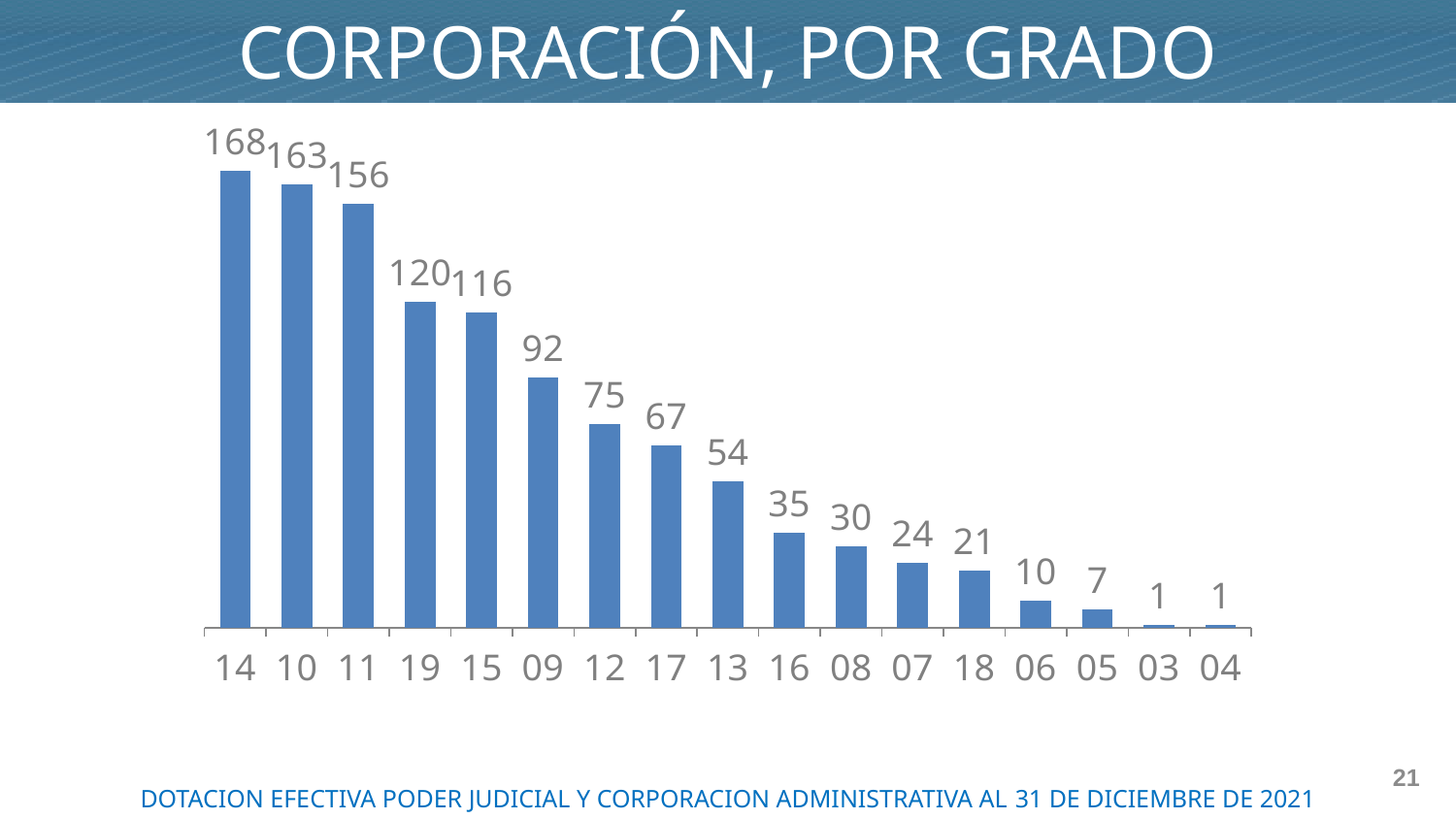
What is the value for grado 09? 92 What kind of chart is shown on the slide? bar chart Do the values rise or fall from left to right along the x axis? fall What is the difference between the values for grado 14 and grado 11? 12 What is the value for grado 18? 21 What is the difference between the values for grado 19 and grado 12? 45 How many grados (categories) are shown on the chart? 17 What is the value for grado 14? 168 What is the lowest value shown on the chart? 1 Which grado has the highest value? 14 What is the title of the chart? CORPORACIÓN, POR GRADO Which is larger, the value for grado 16 or the value for grado 08? 16